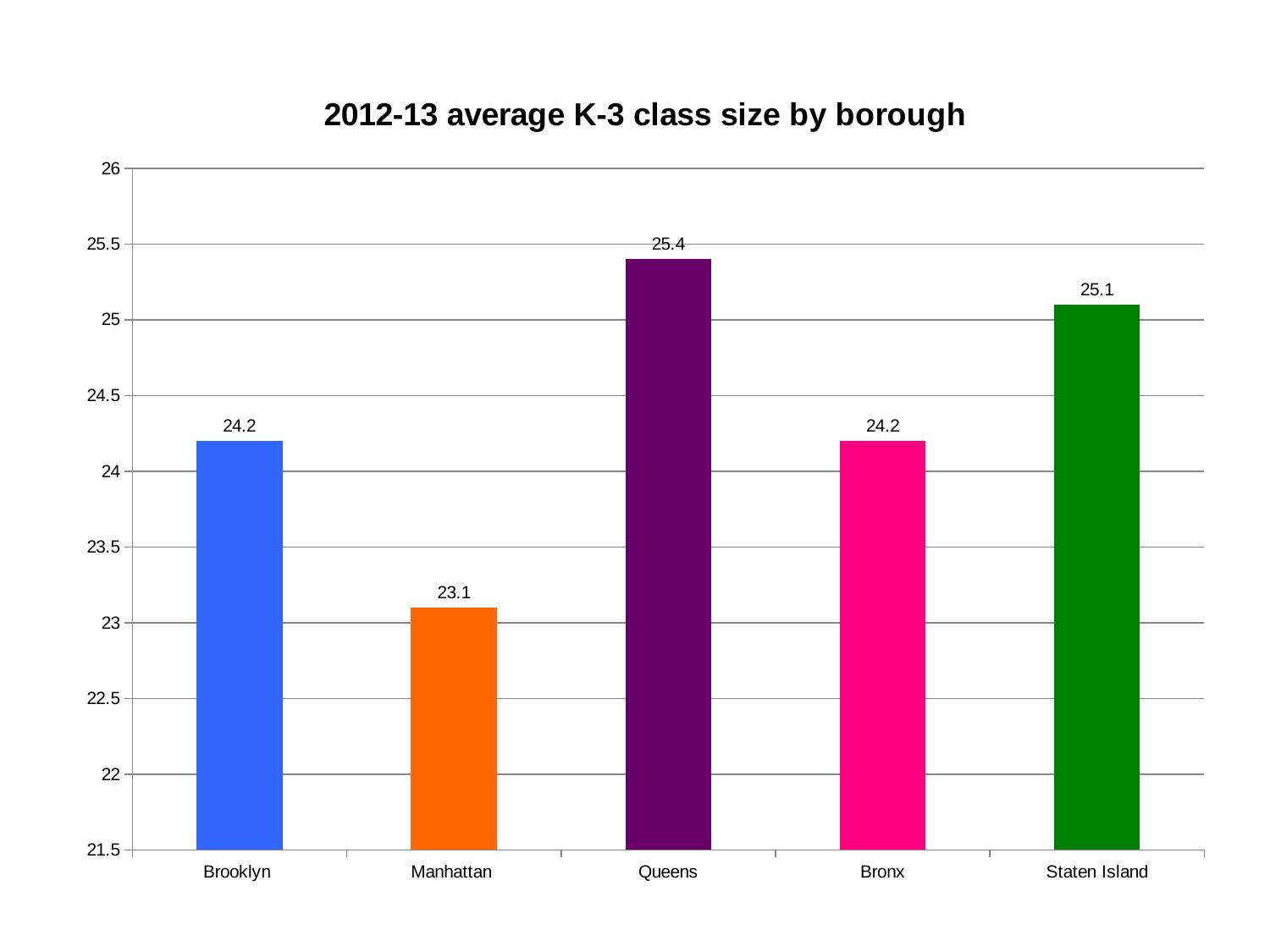
How many boroughs are shown in the chart? 5 What is the average K-3 class size for Staten Island? 25.1 What is the average K-3 class size for Queens? 25.4 Which borough has the highest average K-3 class size? Queens Which has a larger average K-3 class size, Staten Island or the Bronx? Staten Island What kind of chart is shown on the slide? bar chart What is the difference between the average K-3 class size in Queens and in Manhattan? 2.3 What is the difference between the average K-3 class size in Staten Island and in Brooklyn? 0.9 What is the title of the chart? 2012-13 average K-3 class size by borough Is the average K-3 class size for Brooklyn greater or less than 24? greater Which borough has the lowest average K-3 class size? Manhattan What is the average K-3 class size for Manhattan? 23.1